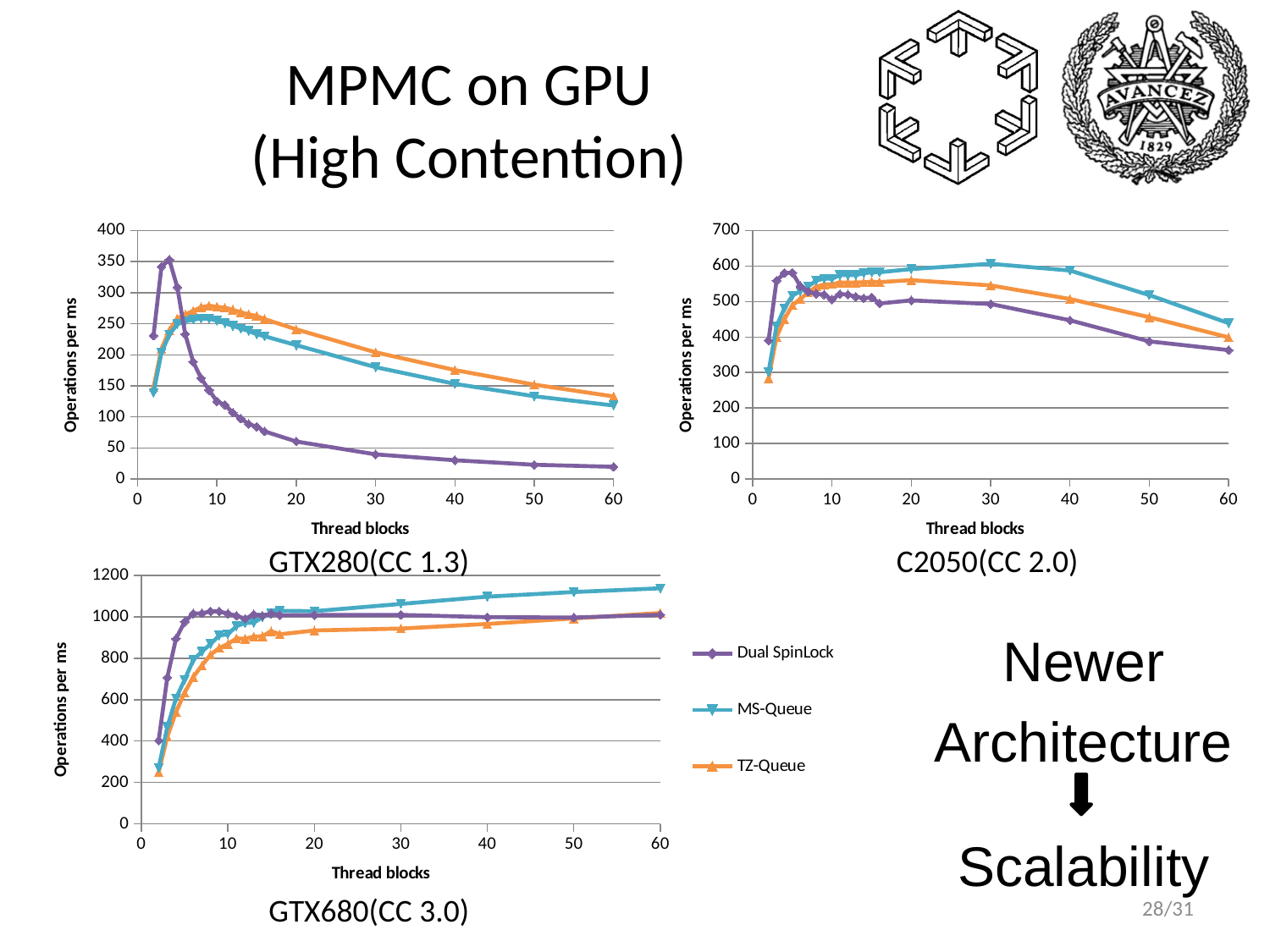
What is the x-axis title of the C2050(CC 2.0) chart? Thread blocks In the C2050(CC 2.0) chart, is the value for Dual SpinLock at 60 thread blocks greater or less than 400? less In the GTX280(CC 1.3) chart, is the value for Dual SpinLock at 60 thread blocks greater or less than 50? less In the GTX680(CC 3.0) chart, does the MS-Queue series rise or fall between 20 and 60 thread blocks? rise In the GTX280(CC 1.3) chart, does the Dual SpinLock series rise or fall between 10 and 60 thread blocks? fall In the GTX280(CC 1.3) chart, is the value for TZ-Queue at 60 thread blocks greater or less than 100? greater In the C2050(CC 2.0) chart, which series is higher at 60 thread blocks, MS-Queue or Dual SpinLock? MS-Queue In the GTX280(CC 1.3) chart, which series has the highest peak value? Dual SpinLock How many series does the legend list for the charts on this slide? 3 What kind of chart is the GTX280(CC 1.3) chart? line chart In the GTX680(CC 3.0) chart, which series is higher at 60 thread blocks, MS-Queue or TZ-Queue? MS-Queue